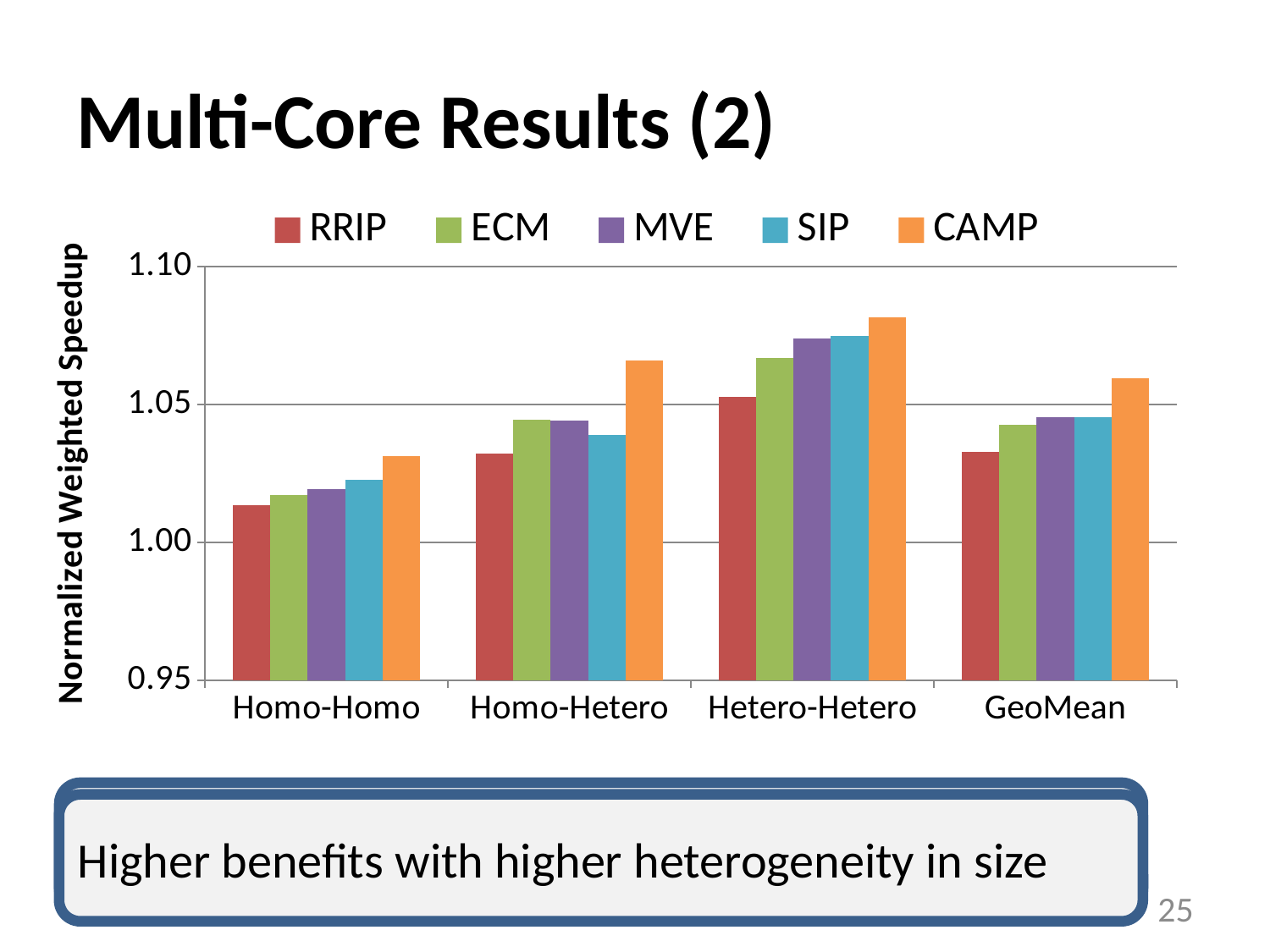
Which is larger: the CAMP value for Homo-Homo or the CAMP value for Hetero-Hetero? Hetero-Hetero What kind of chart is shown on the slide? bar chart Which is larger for Homo-Hetero: RRIP or ECM? ECM How many categories are shown on the x axis? 4 For which category is the CAMP value highest? Hetero-Hetero Is the RRIP value for Homo-Homo greater or less than 1.05? less How many series does the legend list? 5 What is the label on the y axis? Normalized Weighted Speedup Which series has the highest value for Hetero-Hetero? CAMP Is the SIP value for Hetero-Hetero greater or less than 1.05? greater Is the CAMP value for Homo-Hetero greater or less than 1.05? greater Which series has the lowest value for Homo-Homo? RRIP